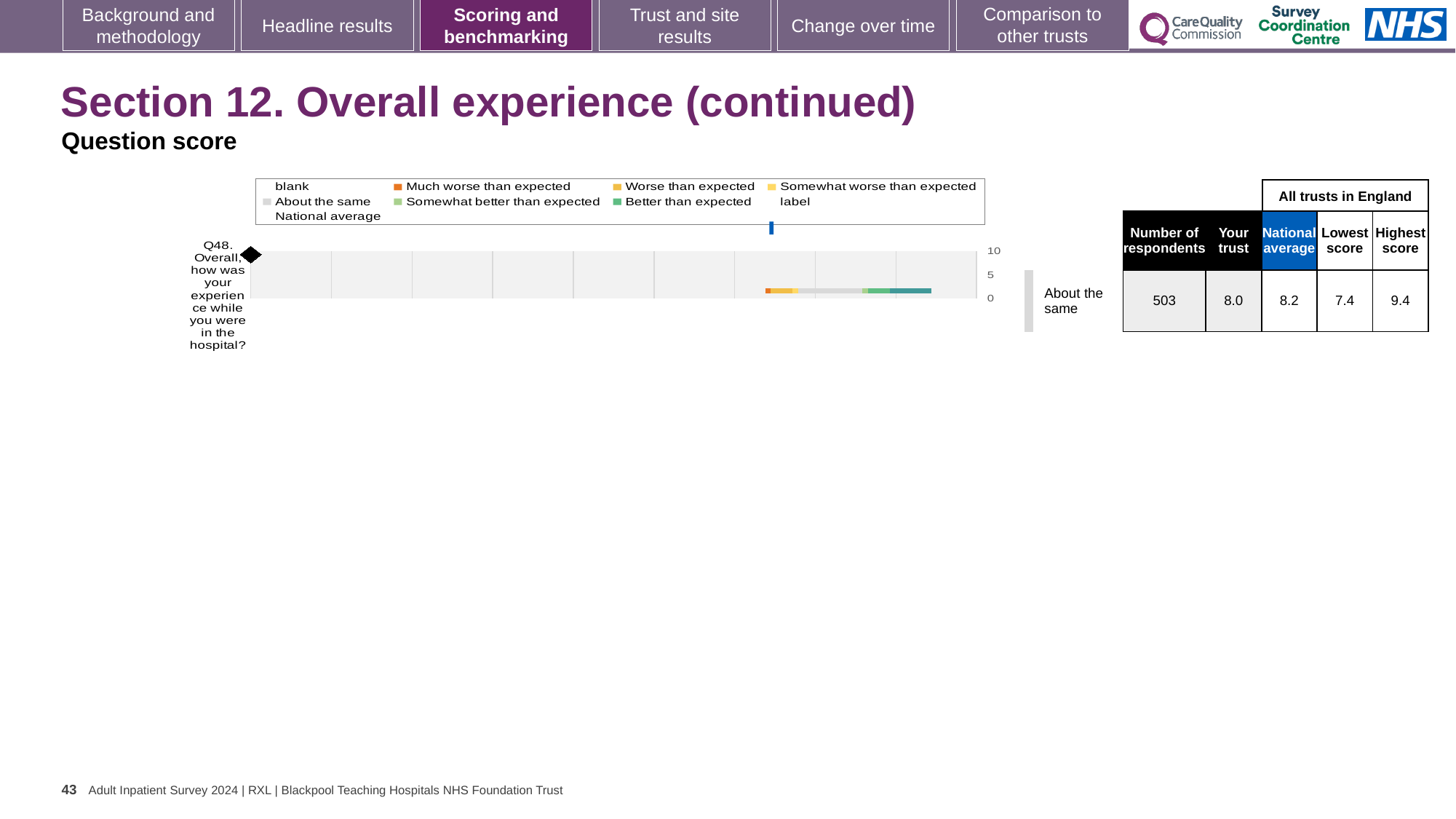
In the table beside the chart, what is the highest score among all trusts in England for Q48? 9.4 Which question is plotted on the chart? Q48. Overall, how was your experience while you were in the hospital? What kind of chart is shown on the slide? bar chart In the table beside the chart, what is the number of respondents for Q48? 503 In the table beside the chart, what is the 'Your trust' score for Q48? 8.0 According to the label next to the chart, how does the trust's result for Q48 compare with expectation? About the same In the table beside the chart, what is the difference between the highest score and the lowest score for Q48? 2.0 How many questions (categories) are plotted on the chart? 1 What is the highest value shown on the chart's axis? 10 In the table beside the chart, which is larger for Q48: the 'Your trust' score or the national average? National average In the table beside the chart, what is the lowest score among all trusts in England for Q48? 7.4 In the table beside the chart, what is the national average score for Q48? 8.2